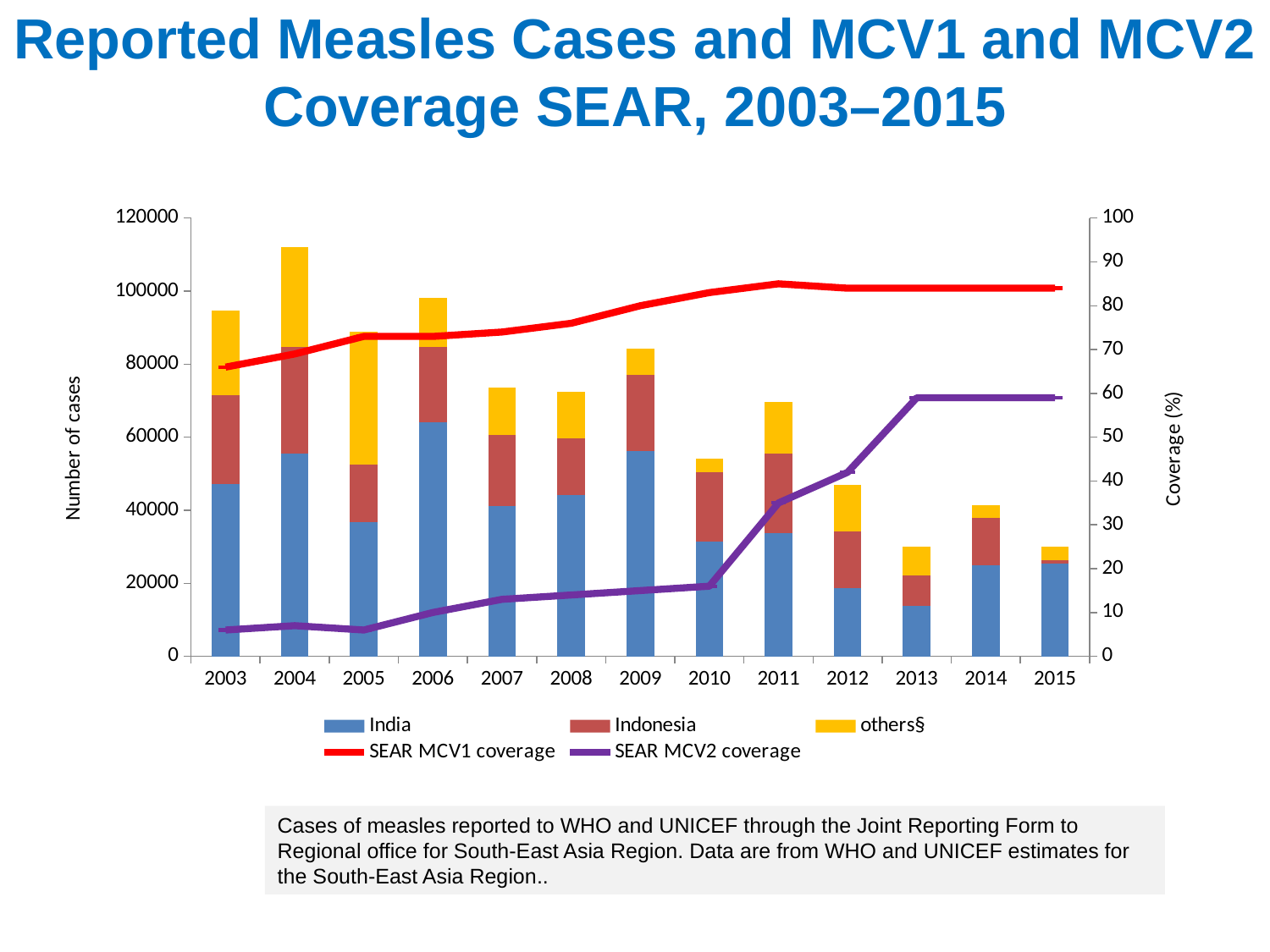
Which year has the highest number of cases for India? 2006 Is the SEAR MCV2 coverage in 2015 greater or less than 50? greater What kind of chart is used to show the number of measles cases? Stacked bar chart What is the label of the right-hand vertical axis? Coverage (%) How many years are shown on the x axis? 13 Is the SEAR MCV1 coverage in 2003 greater or less than 70? less How many series does the legend list? 5 Which year has the larger total number of cases, 2009 or 2010? 2009 Which year has the lowest number of cases for India? 2013 Which year has the highest total number of reported measles cases? 2004 Is the total number of cases in 2004 greater or less than 100000? greater Does the SEAR MCV2 coverage rise or fall from 2003 to 2015? rise